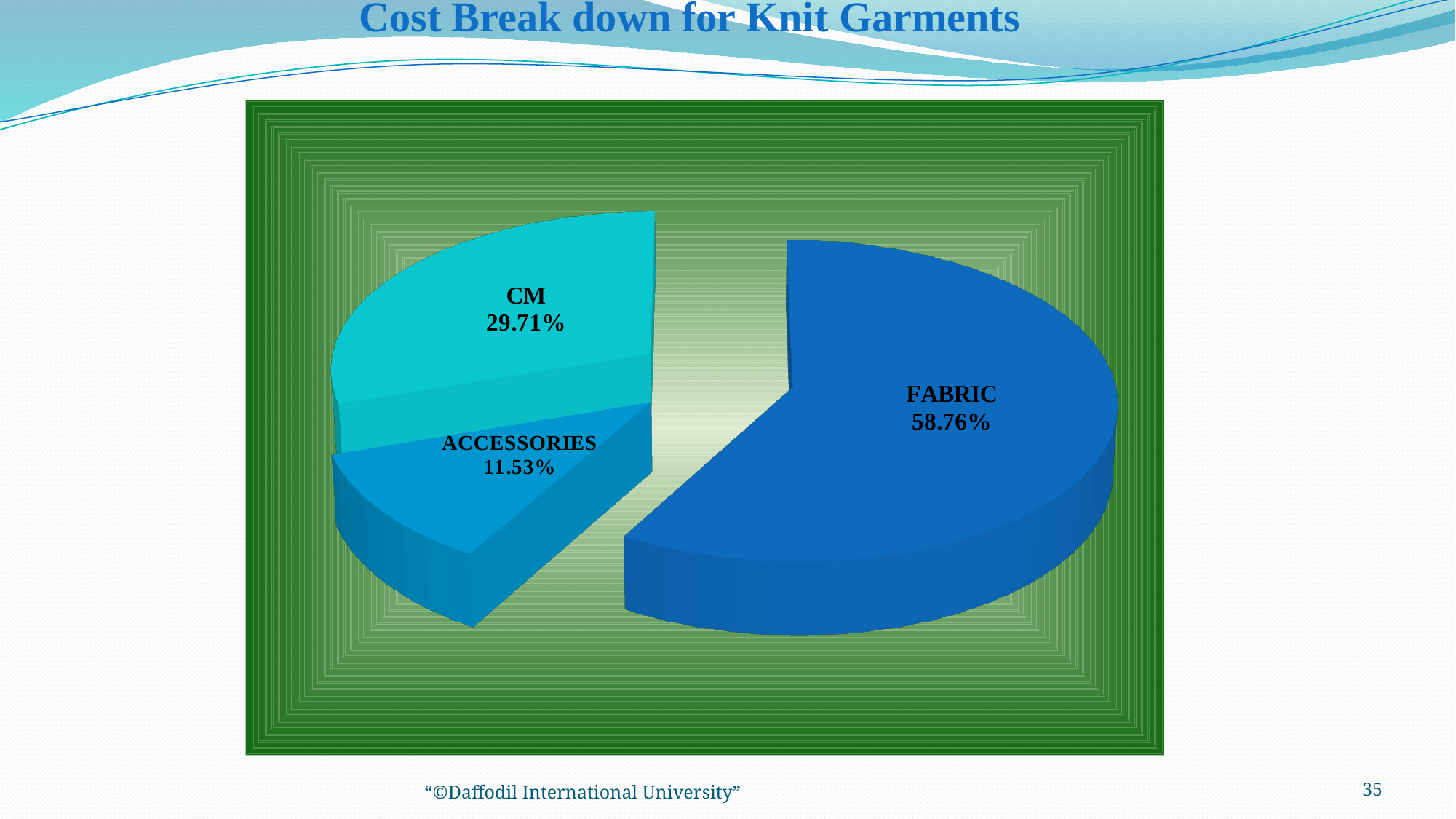
What kind of chart is shown on the slide? Pie chart What is the difference between the CM share and the ACCESSORIES share? 18.18% What share of the cost does CM account for? 29.71% What share of the cost does ACCESSORIES account for? 11.53% Which category has the smallest share of the cost? ACCESSORIES What is the difference between the FABRIC share and the CM share? 29.05% What share of the cost does FABRIC account for? 58.76% How many categories are shown in the pie chart? 3 Which category has the largest share of the cost? FABRIC What is the title of the slide's chart? Cost Break down for Knit Garments Which is larger, the share for CM or the share for ACCESSORIES? CM What colour is the FABRIC slice? Blue